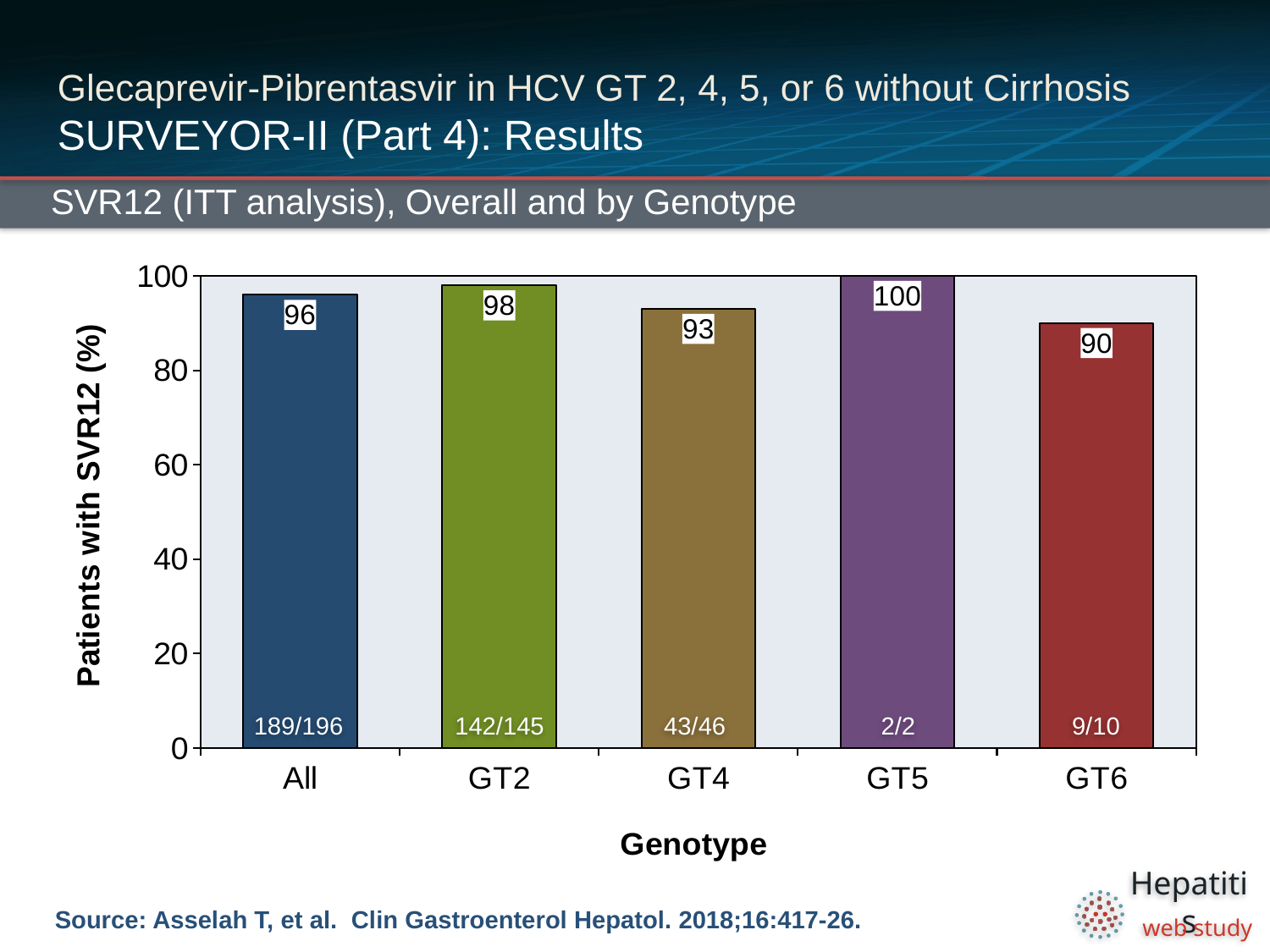
What is the SVR12 rate for GT2? 98 How many bars are shown in the chart? 5 Which genotype has the highest SVR12 rate? GT5 What is the SVR12 rate for GT6? 90 Which genotype has the lowest SVR12 rate? GT6 What is the difference in SVR12 rate between GT5 and GT6? 10 What fraction of patients is shown inside the GT4 bar? 43/46 What type of chart is shown on the slide? bar chart What is the SVR12 rate for the All group? 96 What is the label of the x-axis? Genotype What is the label of the y-axis? Patients with SVR12 (%) Which has a higher SVR12 rate, GT2 or GT4? GT2